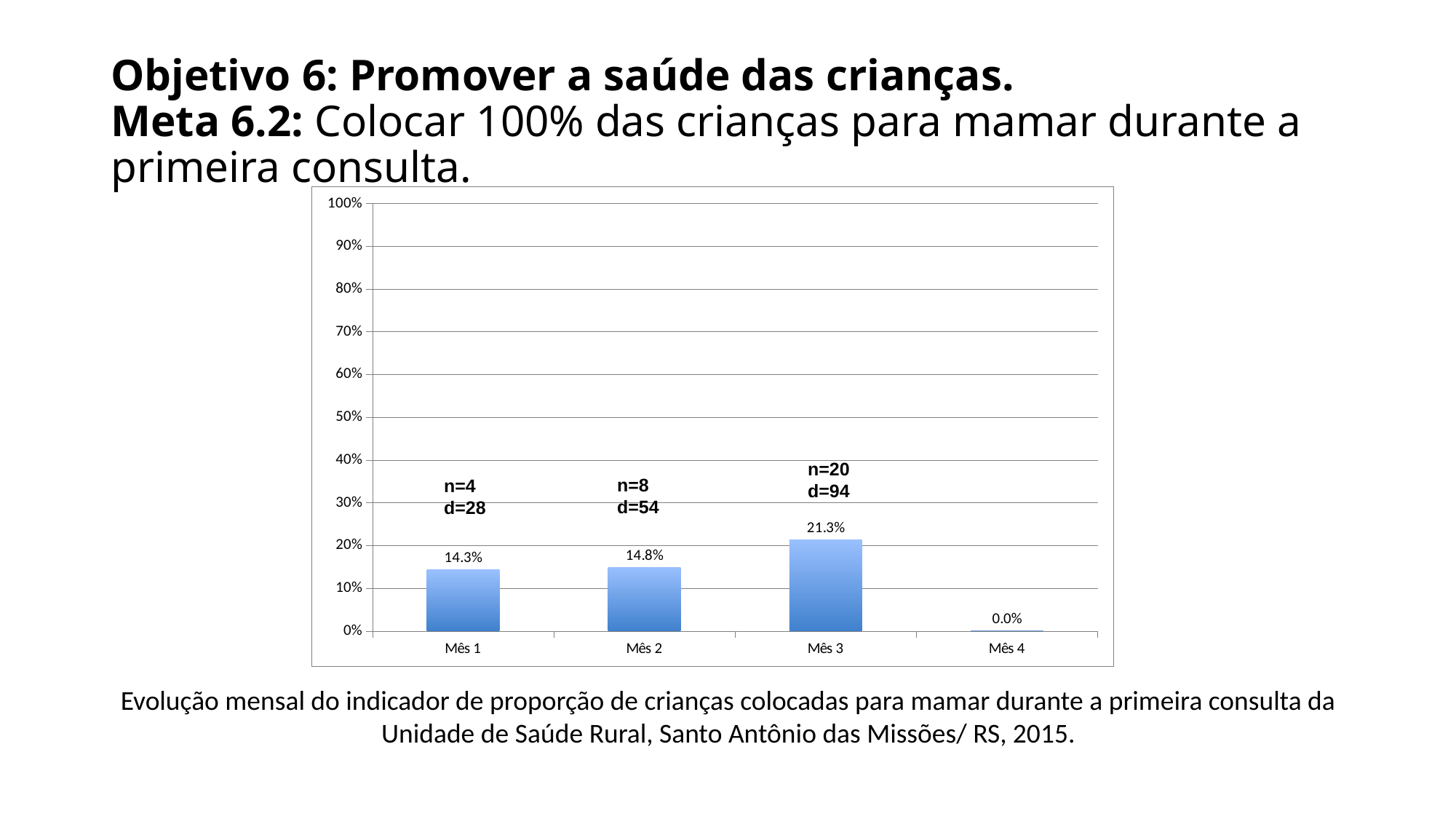
What is the value for Mês 4? 0.0% Which is larger, the value for Mês 3 or the value for Mês 1? Mês 3 Which month has the lowest value? Mês 4 What is the n value annotated above the bar for Mês 3? n=20 Which month has the highest value? Mês 3 Is the value for Mês 3 greater or less than 20%? greater How many months are shown on the x axis? 4 What is the value for Mês 1? 14.3% What is the value for Mês 3? 21.3% What is the d value annotated above the bar for Mês 2? d=54 What is the difference between the values for Mês 3 and Mês 2? 6.5% What kind of chart is shown on the slide? bar chart